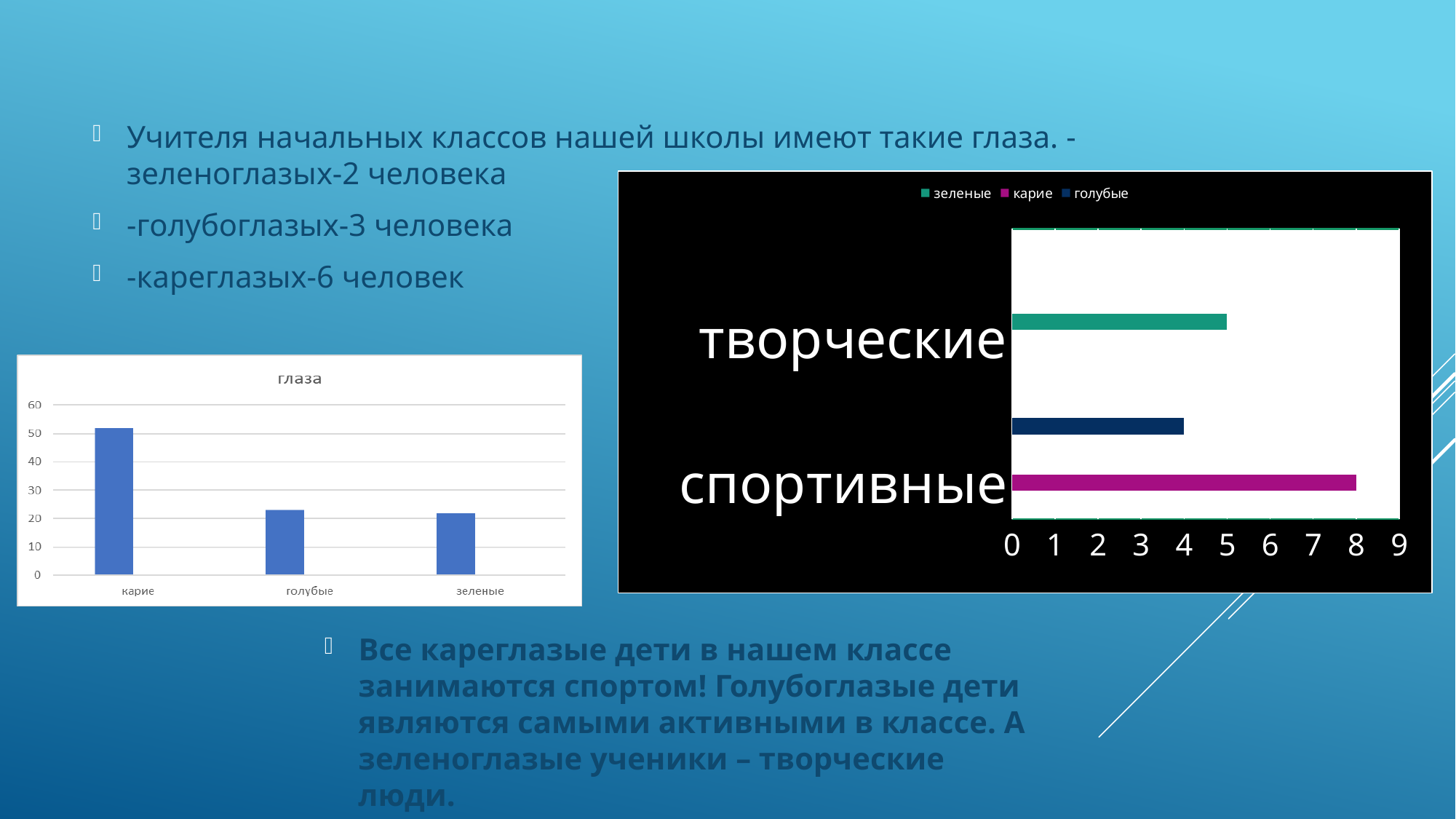
In the chart on the right, which series has the lowest value? голубые In the chart titled "глаза", is the value for голубые greater or less than 30? less What kind of chart is the chart titled "глаза"? bar chart What kind of chart is the chart on the right with the black background? bar chart In the chart on the right, what is the value for зеленые? 5 In the chart on the right, what is the value for карие? 8 How many categories are shown on the x axis of the chart titled "глаза"? 3 In the chart titled "глаза", which is larger, the value for карие or the value for зеленые? карие In the chart titled "глаза", is the value for зеленые greater or less than 30? less How many series does the legend of the chart on the right list? 3 In the chart titled "глаза", which category has the highest value? карие In the chart titled "глаза", is the value for карие greater or less than 40? greater